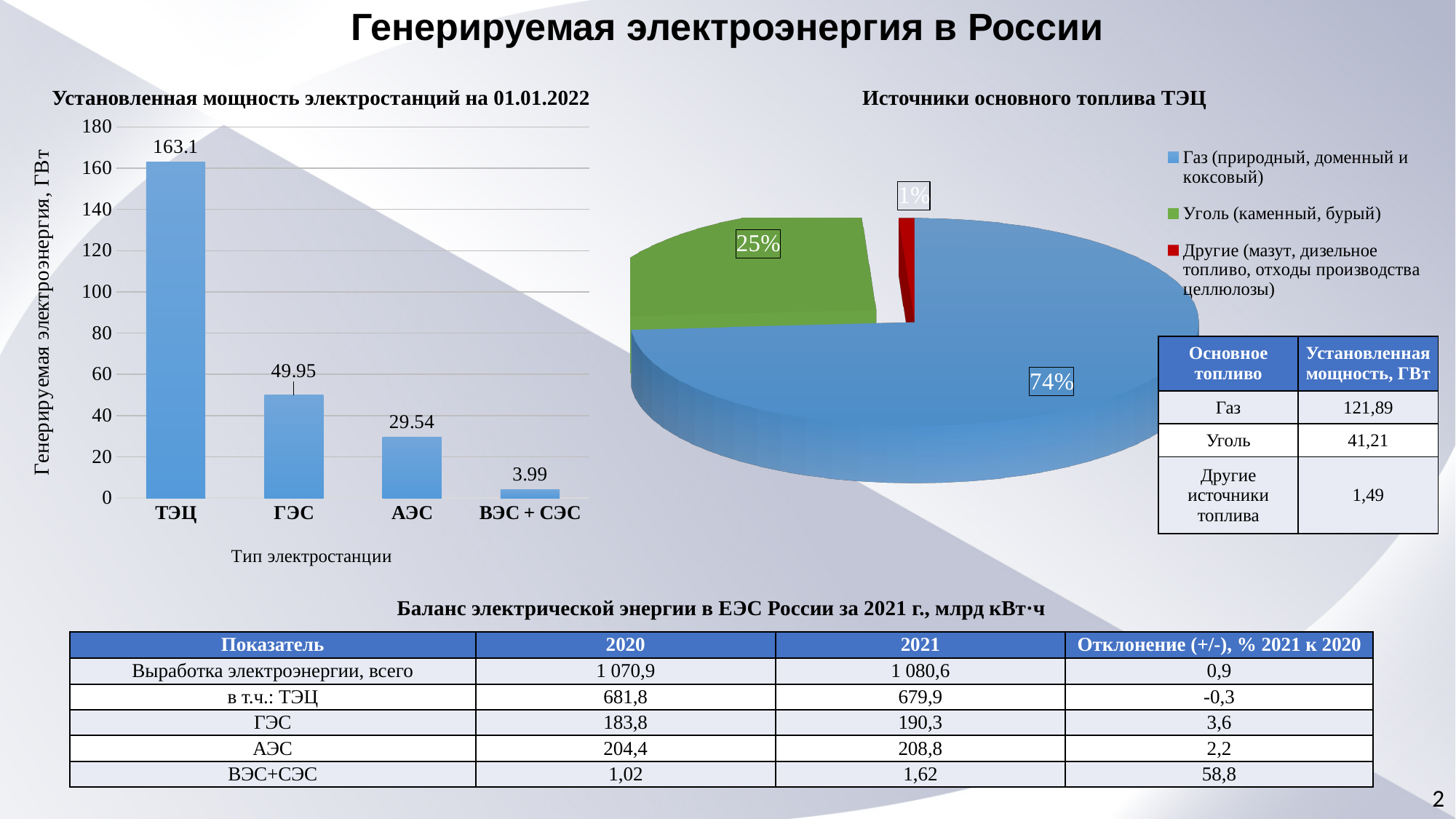
In the pie chart 'Источники основного топлива ТЭЦ', what share does Уголь (каменный, бурый) have? 25% In the chart 'Установленная мощность электростанций на 01.01.2022', what is the value for ВЭС + СЭС? 3.99 In the pie chart 'Источники основного топлива ТЭЦ', what share does Газ (природный, доменный и коксовый) have? 74% What kind of chart is 'Установленная мощность электростанций на 01.01.2022'? Bar chart How many entries does the legend of the pie chart 'Источники основного топлива ТЭЦ' list? 3 In the chart 'Установленная мощность электростанций на 01.01.2022', how many types of power plants are shown? 4 In the chart 'Установленная мощность электростанций на 01.01.2022', what is the value for ТЭЦ? 163.1 In the chart 'Установленная мощность электростанций на 01.01.2022', which type of power plant has the highest installed capacity? ТЭЦ In the chart 'Установленная мощность электростанций на 01.01.2022', what is the value for ГЭС? 49.95 In the chart 'Установленная мощность электростанций на 01.01.2022', what is the difference between the values for ГЭС and АЭС? 20.41 In the chart 'Установленная мощность электростанций на 01.01.2022', which type of power plant has the lowest installed capacity? ВЭС + СЭС In the pie chart 'Источники основного топлива ТЭЦ', which fuel source has the smallest share? Другие (мазут, дизельное топливо, отходы производства целлюлозы)